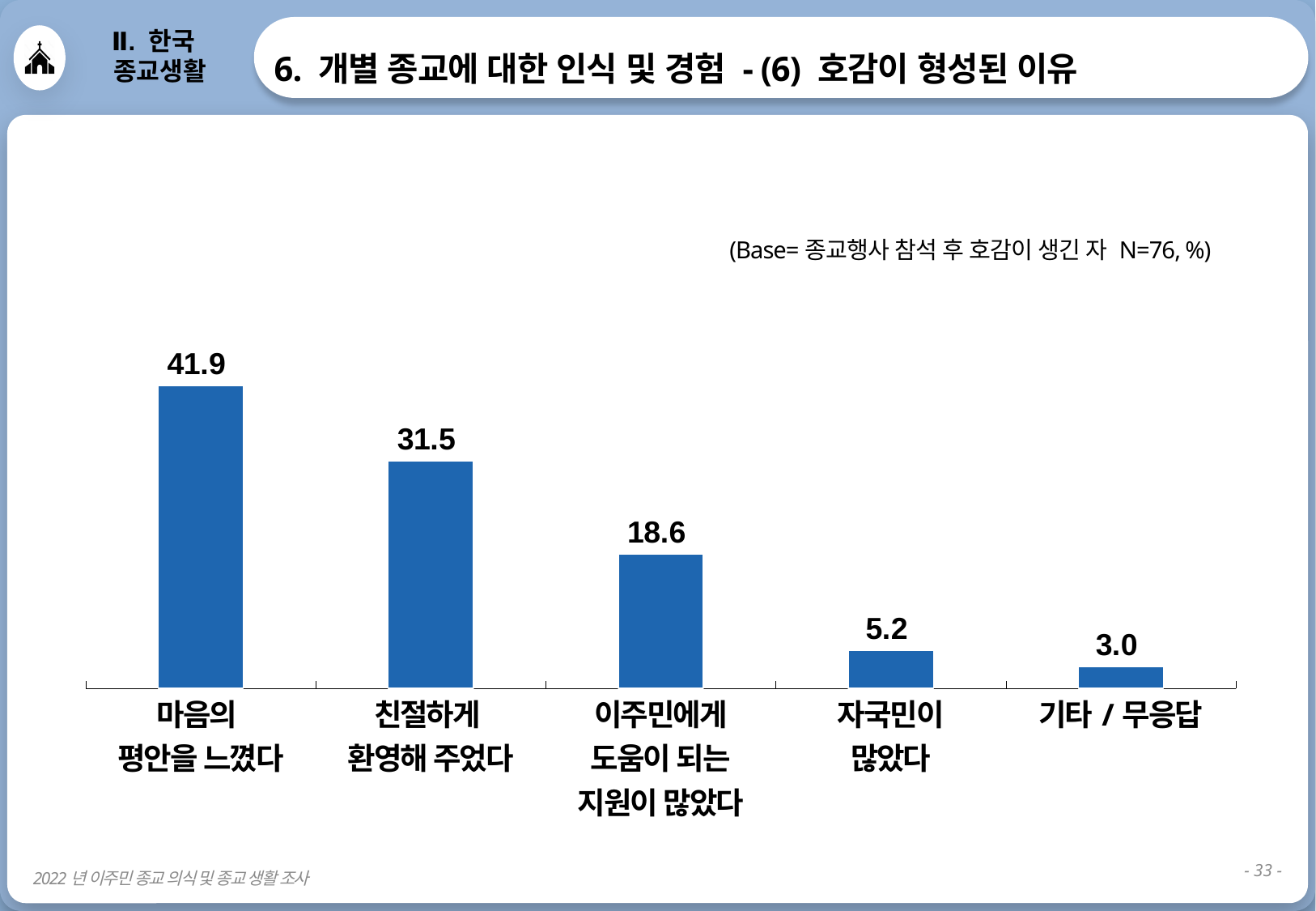
What is the value for 이주민에게 도움이 되는 지원이 많았다? 18.6 How many categories are shown in the chart? 5 What is the difference between the values for 마음의 평안을 느꼈다 and 친절하게 환영해 주었다? 10.4 Which category has the highest value? 마음의 평안을 느꼈다 Do the values rise or fall from left to right along the x axis? Fall What kind of chart is shown on the slide? Bar chart What is the value for 기타 / 무응답? 3.0 What is the value for 자국민이 많았다? 5.2 What is the value for 마음의 평안을 느꼈다? 41.9 Which is larger, the value for 이주민에게 도움이 되는 지원이 많았다 or the value for 자국민이 많았다? 이주민에게 도움이 되는 지원이 많았다 What is the value for 친절하게 환영해 주었다? 31.5 Which category has the lowest value? 기타 / 무응답